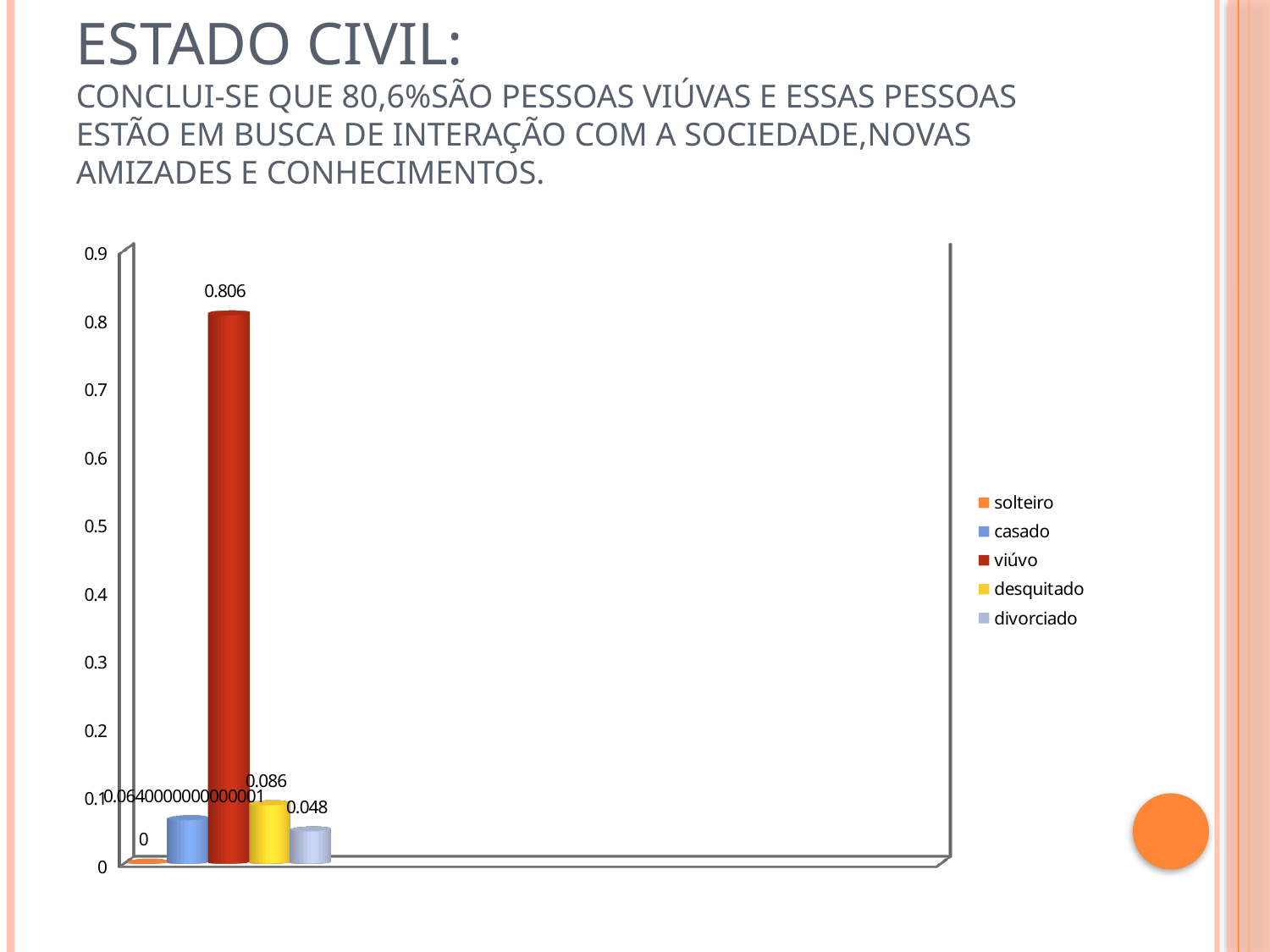
Which category has the highest value? viúvo What is the value for viúvo? 0.806 Which is larger, the value for desquitado or the value for divorciado? desquitado What is the difference between the values for viúvo and desquitado? 0.72 What is the difference between the values for desquitado and divorciado? 0.038 How many series does the legend list? 5 Which category has the lowest value? solteiro What is the value for solteiro? 0 What is the value for divorciado? 0.048 Is the value for casado greater or less than 0.1? less What is the value for desquitado? 0.086 What kind of chart is shown on the slide? bar chart